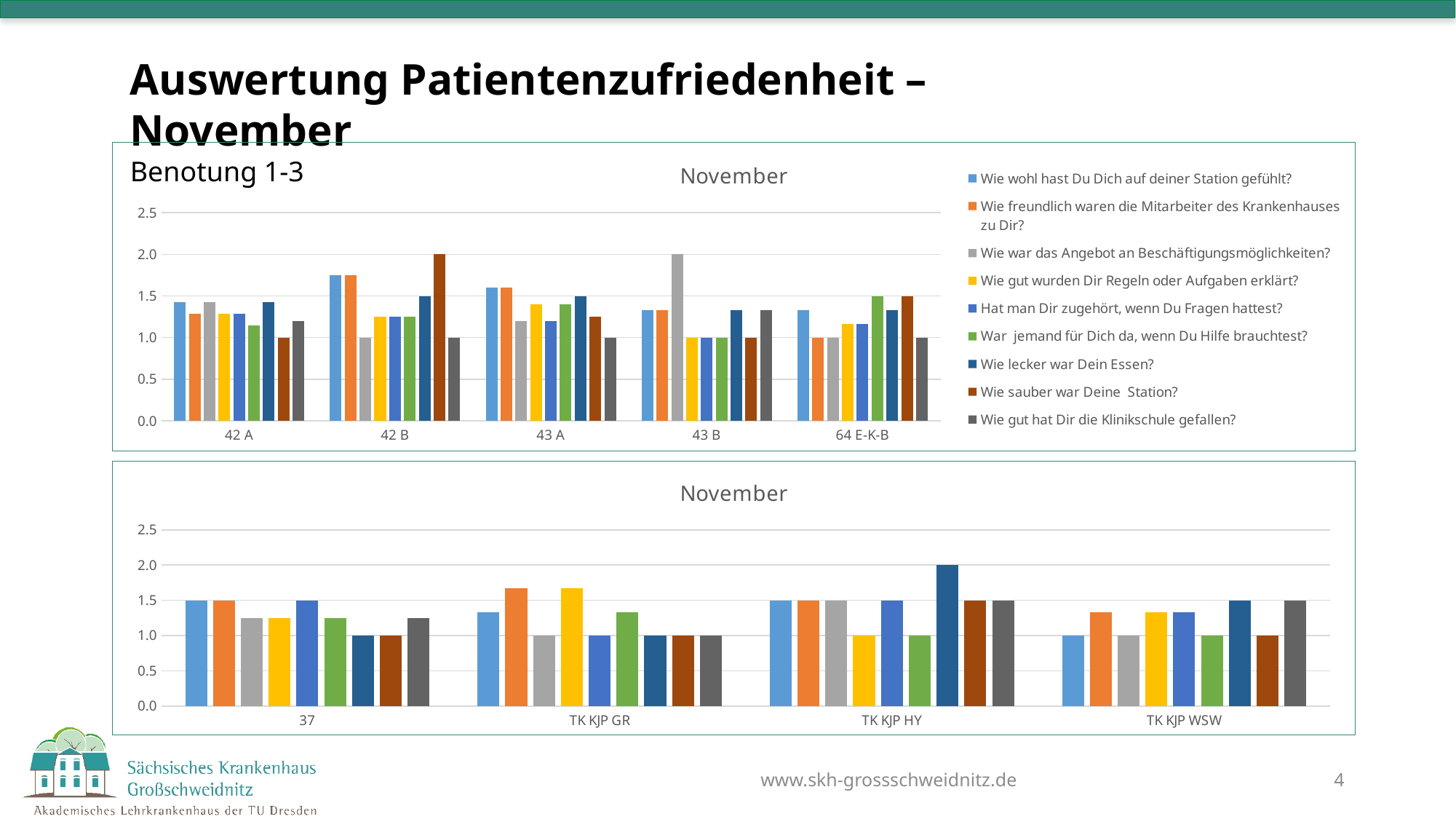
In the top chart, what is the value for 43 B for the series "Wie war das Angebot an Beschäftigungsmöglichkeiten?"? 2.0 In the top chart, is the value for 42 B for "Wie wohl hast Du Dich auf deiner Station gefühlt?" greater or less than 1.5? greater In the top chart, what is the value for 42 B for the series "Wie sauber war Deine Station?"? 2.0 What kind of chart is the top chart on the slide? bar chart How many categories are shown on the x axis of the bottom chart? 4 How many series does the legend of the top chart list? 9 How many categories are shown on the x axis of the top chart? 5 In the bottom chart, is the value of the orange bar for TK KJP GR greater or less than 1.5? greater In the bottom chart, what is the value of the tallest bar for TK KJP HY? 2.0 In the top chart, for 42 A, which is larger: "Wie wohl hast Du Dich auf deiner Station gefühlt?" or "Wie sauber war Deine Station?"? Wie wohl hast Du Dich auf deiner Station gefühlt? In the top chart, which series has the highest value for 43 B? Wie war das Angebot an Beschäftigungsmöglichkeiten? In the bottom chart, what is the value of the first (light blue) bar for category 37? 1.5